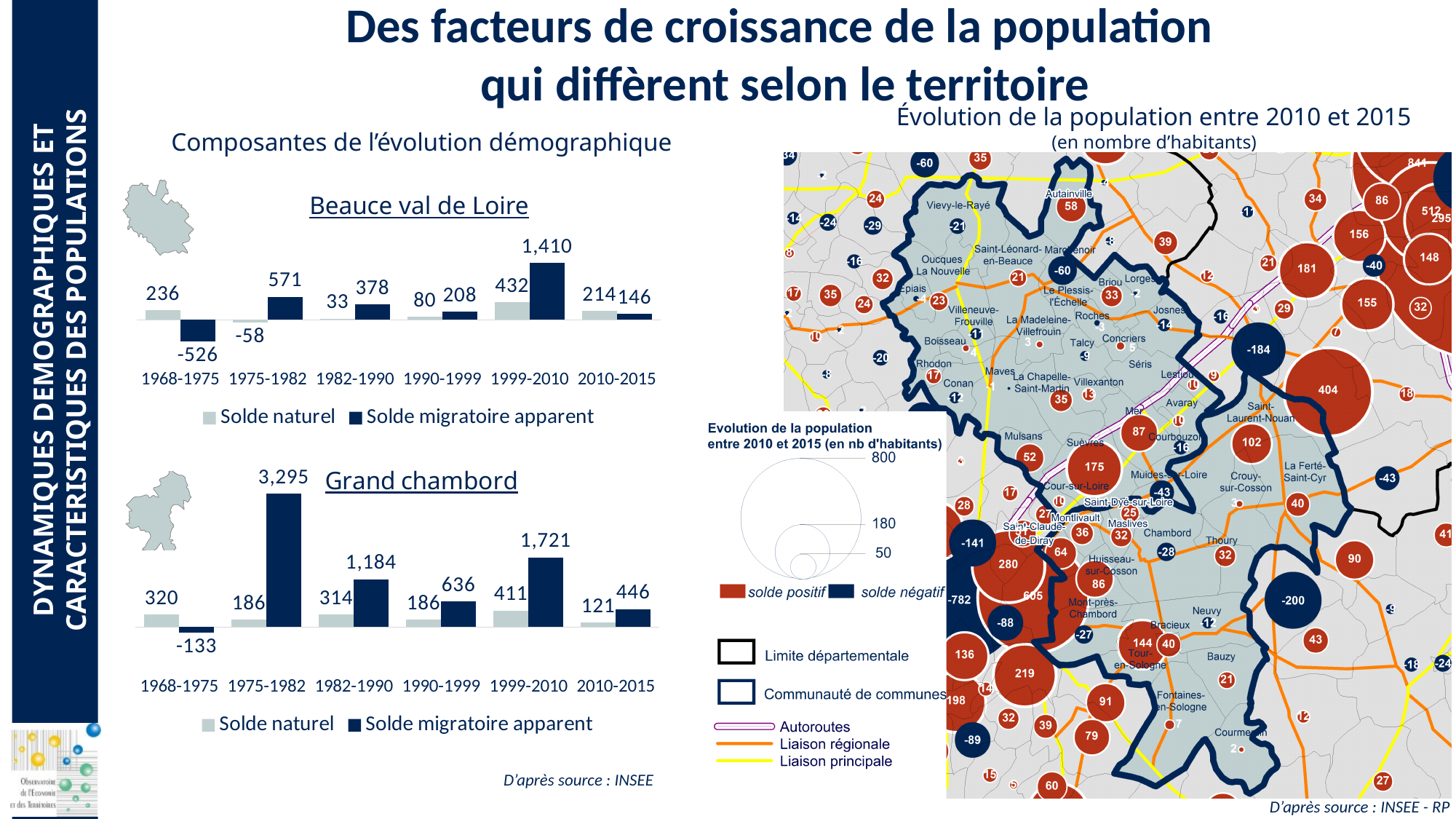
How many series does the legend of the Beauce val de Loire chart list? 2 In the Beauce val de Loire chart, what is the value of Solde naturel for 1968-1975? 236 In the Grand chambord chart, which period has the highest Solde naturel? 1999-2010 In the Beauce val de Loire chart, what is the difference between Solde migratoire apparent and Solde naturel for 2010-2015? 68 In the Beauce val de Loire chart, what is the value of Solde migratoire apparent for 1999-2010? 1,410 How many periods are shown on the x axis of the Grand chambord chart? 6 In the Beauce val de Loire chart, which period has the lowest Solde migratoire apparent? 1968-1975 In the Grand chambord chart, what is the difference between Solde migratoire apparent and Solde naturel for 1999-2010? 1,310 In the Grand chambord chart, what is the value of Solde migratoire apparent for 1968-1975? -133 In the Grand chambord chart, what is the value of Solde migratoire apparent for 1975-1982? 3,295 What type of chart is used for Grand chambord? Bar chart In the Beauce val de Loire chart, which is larger for 2010-2015: Solde naturel or Solde migratoire apparent? Solde naturel